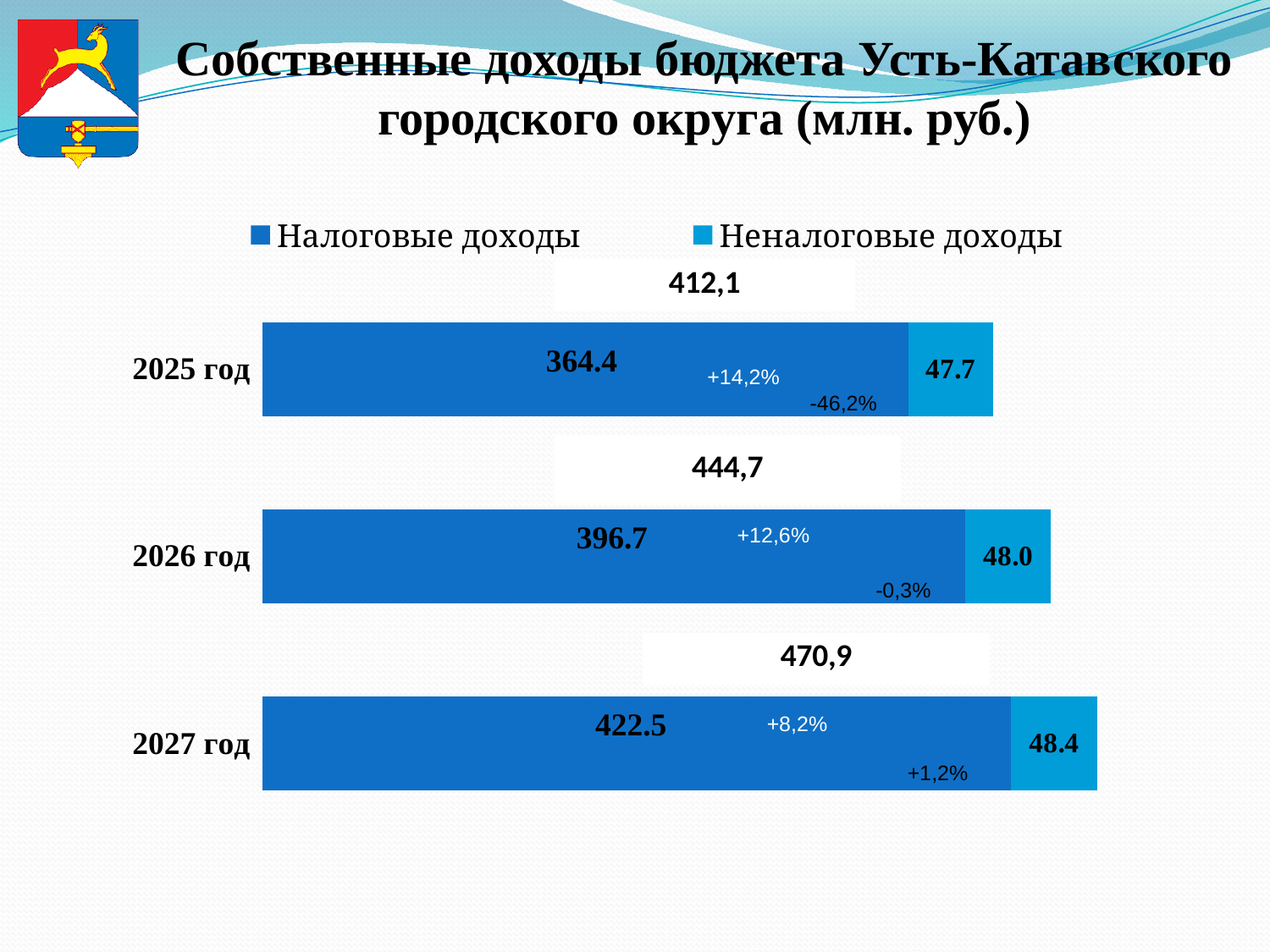
What is the value of Налоговые доходы for 2027 год? 422.5 What is the total shown above the bar for 2026 год? 444,7 Which year has the lowest value of Неналоговые доходы? 2025 год How many years are shown in the chart? 3 What is the difference between Налоговые доходы in 2027 год and 2026 год? 25.8 Do the total values rise or fall from 2025 год to 2027 год? Rise Which year has the highest value of Налоговые доходы? 2027 год What kind of chart is shown on the slide? Stacked bar chart How many series does the legend list? 2 What is the value of Налоговые доходы for 2025 год? 364.4 What is the value of Неналоговые доходы for 2026 год? 48.0 Which is larger: Неналоговые доходы in 2027 год or in 2025 год? 2027 год